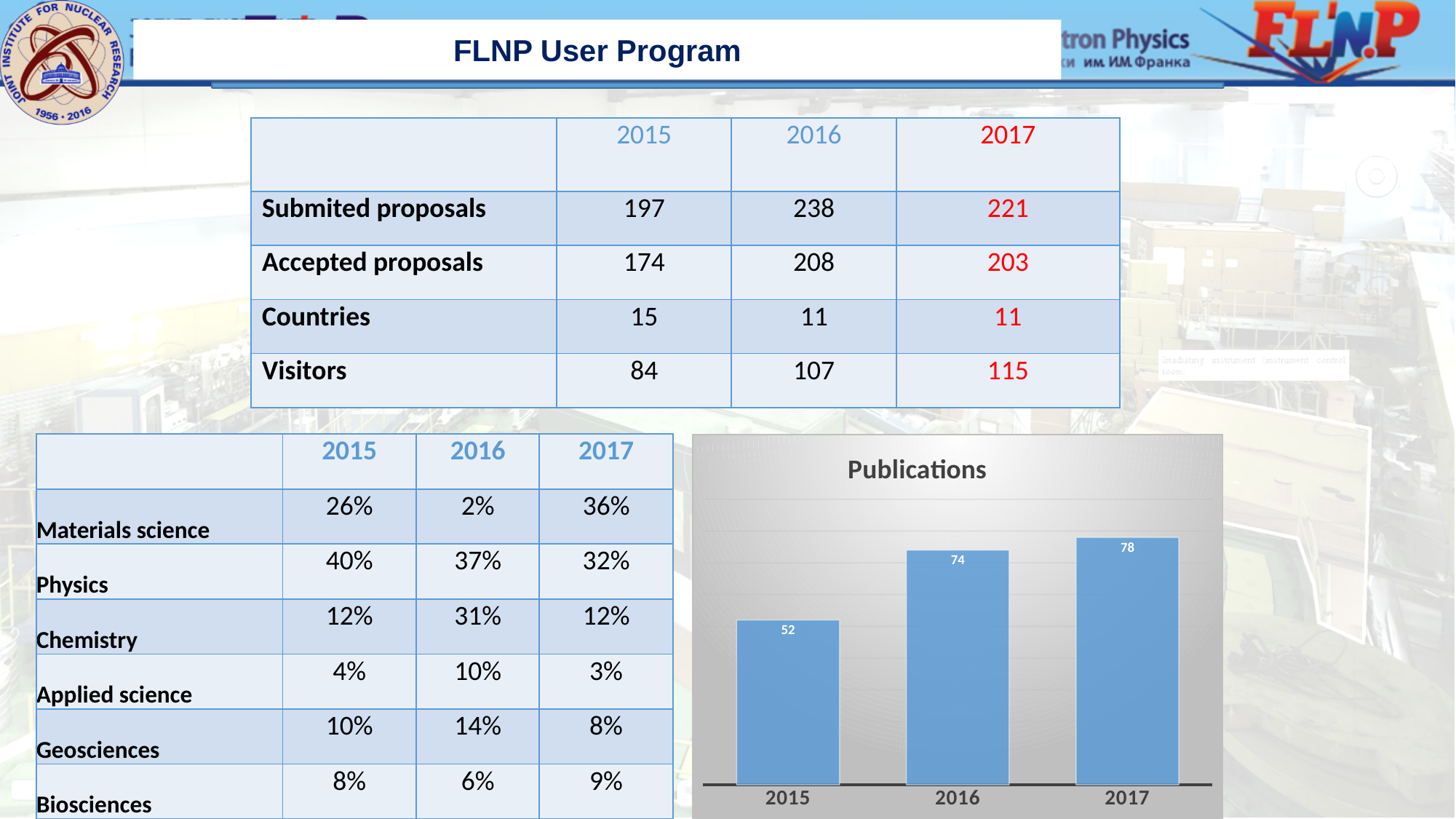
In the Publications chart, which year has the highest value? 2017 In the Publications chart, do the values rise or fall from 2015 to 2017? rise How many bars are shown in the Publications chart? 3 In the Publications chart, which year has the lowest value? 2015 What kind of chart is the Publications chart? bar chart What is the title of the chart on the slide? Publications In the Publications chart, what is the value for 2015? 52 In the Publications chart, what is the difference between the values for 2016 and 2015? 22 In the Publications chart, which is larger, the value for 2015 or the value for 2016? 2016 In the Publications chart, what is the value for 2017? 78 In the Publications chart, what is the value for 2016? 74 In the Publications chart, what is the difference between the values for 2017 and 2016? 4